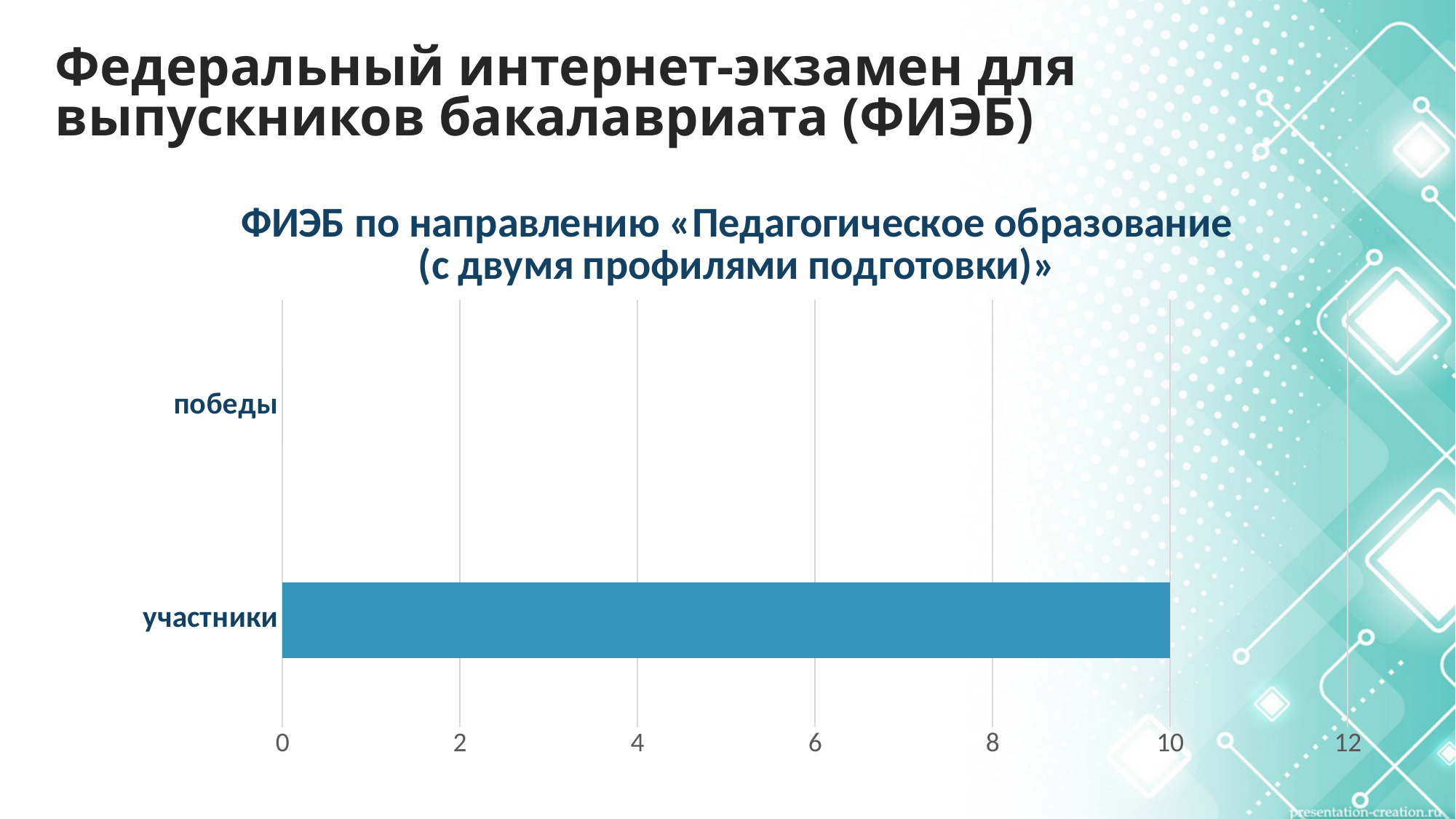
Is the value for победы greater or less than 2? less Which category has the lowest value? победы What is the title of the chart? ФИЭБ по направлению «Педагогическое образование (с двумя профилями подготовки)» Which category has the highest value? участники What kind of chart is shown on the slide? bar chart Is the value for участники greater or less than 8? greater How many categories are shown on the chart? 2 What is the value for участники? 10 What is the highest value shown on the horizontal axis? 12 Which is larger, the value for участники or the value for победы? участники Is the value for участники greater or less than 12? less